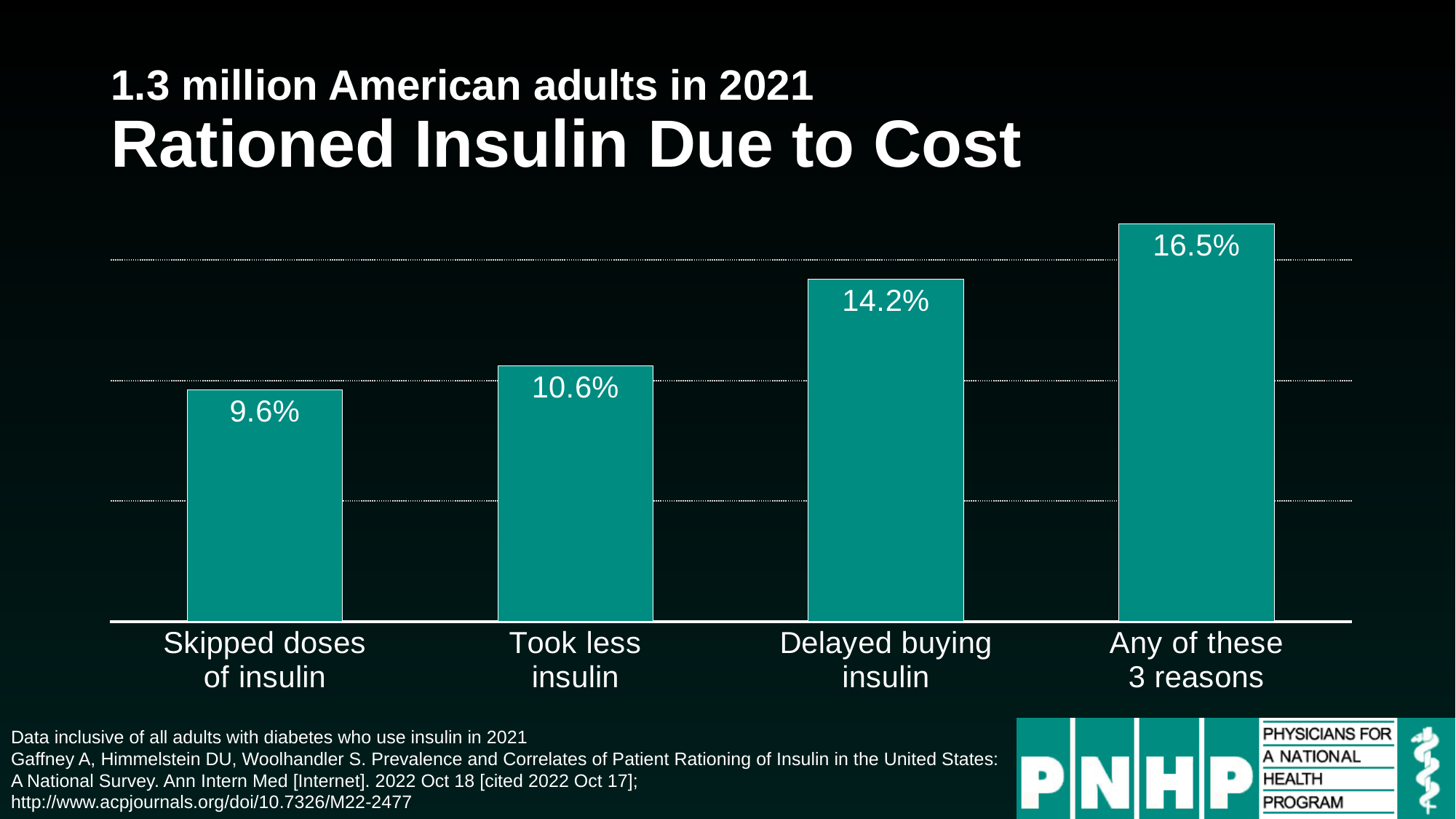
What percentage of adults skipped doses of insulin? 9.6% How many categories are shown in the chart? 4 Which category has the lowest value? Skipped doses of insulin What kind of chart is shown on the slide? Bar chart What percentage delayed buying insulin? 14.2% What is the difference between 'Delayed buying insulin' and 'Took less insulin'? 3.6% What is the difference between 'Any of these 3 reasons' and 'Skipped doses of insulin'? 6.9% What is the value for 'Any of these 3 reasons'? 16.5% Which is larger: 'Delayed buying insulin' or 'Took less insulin'? Delayed buying insulin Which category has the highest value? Any of these 3 reasons What is the value for 'Took less insulin'? 10.6% Do the values rise or fall from left to right across the categories? Rise